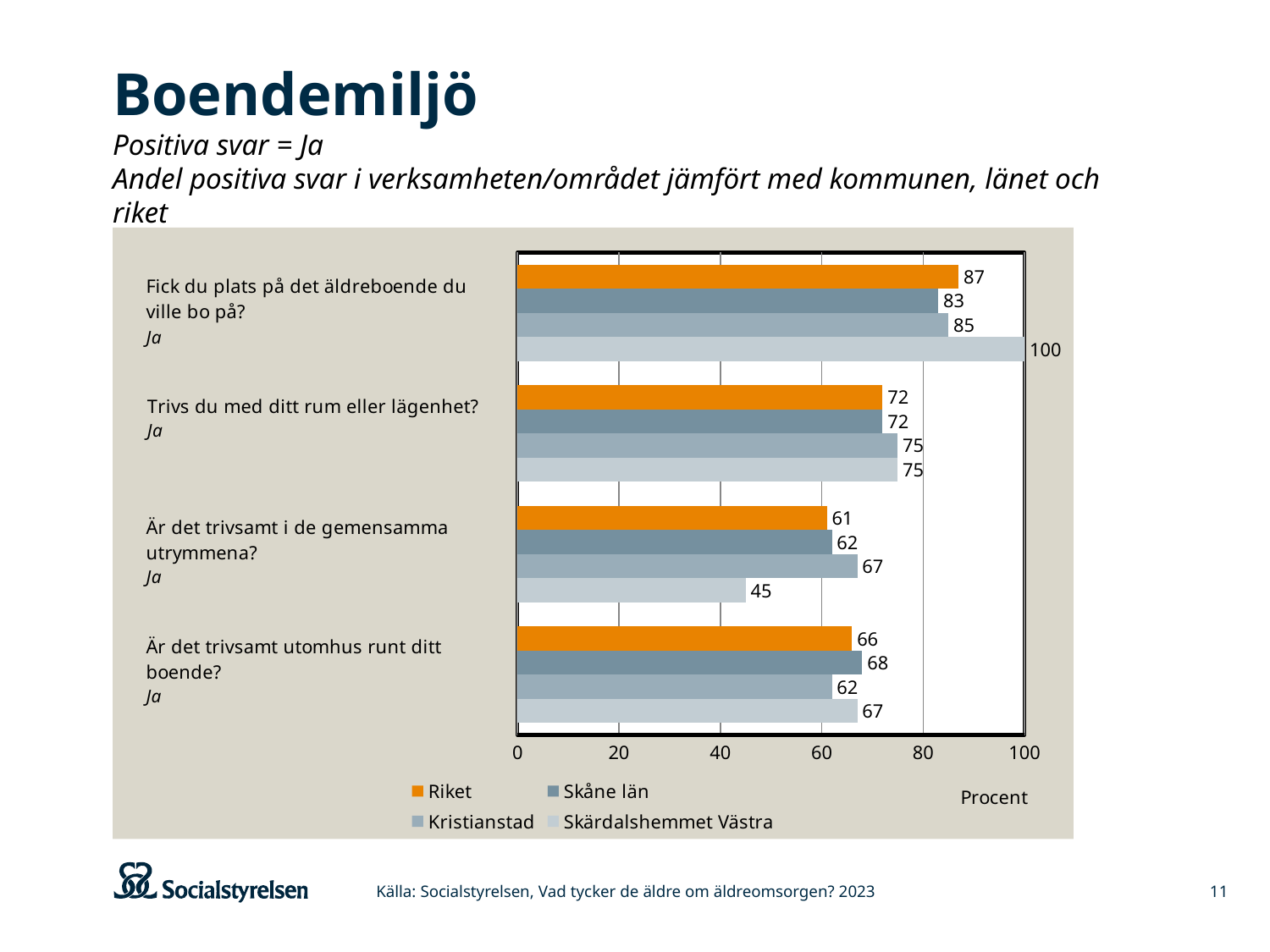
Which series has the highest value for "Fick du plats på det äldreboende du ville bo på?"? Skärdalshemmet Västra What is the value for Skåne län for "Är det trivsamt utomhus runt ditt boende?"? 68 How many series does the legend list? 4 What unit is shown on the horizontal axis of the chart? Procent What is the difference between the Skärdalshemmet Västra value and the Riket value for "Fick du plats på det äldreboende du ville bo på?"? 13 How many questions (categories) are shown on the chart? 4 What kind of chart is shown on the slide? Bar chart What is the value for Skärdalshemmet Västra for "Fick du plats på det äldreboende du ville bo på?"? 100 Which is larger for "Är det trivsamt utomhus runt ditt boende?": the value for Skåne län or the value for Kristianstad? Skåne län What is the value for Kristianstad for "Är det trivsamt i de gemensamma utrymmena?"? 67 Which series has the lowest value for "Är det trivsamt i de gemensamma utrymmena?"? Skärdalshemmet Västra What is the value for Riket for "Trivs du med ditt rum eller lägenhet?"? 72